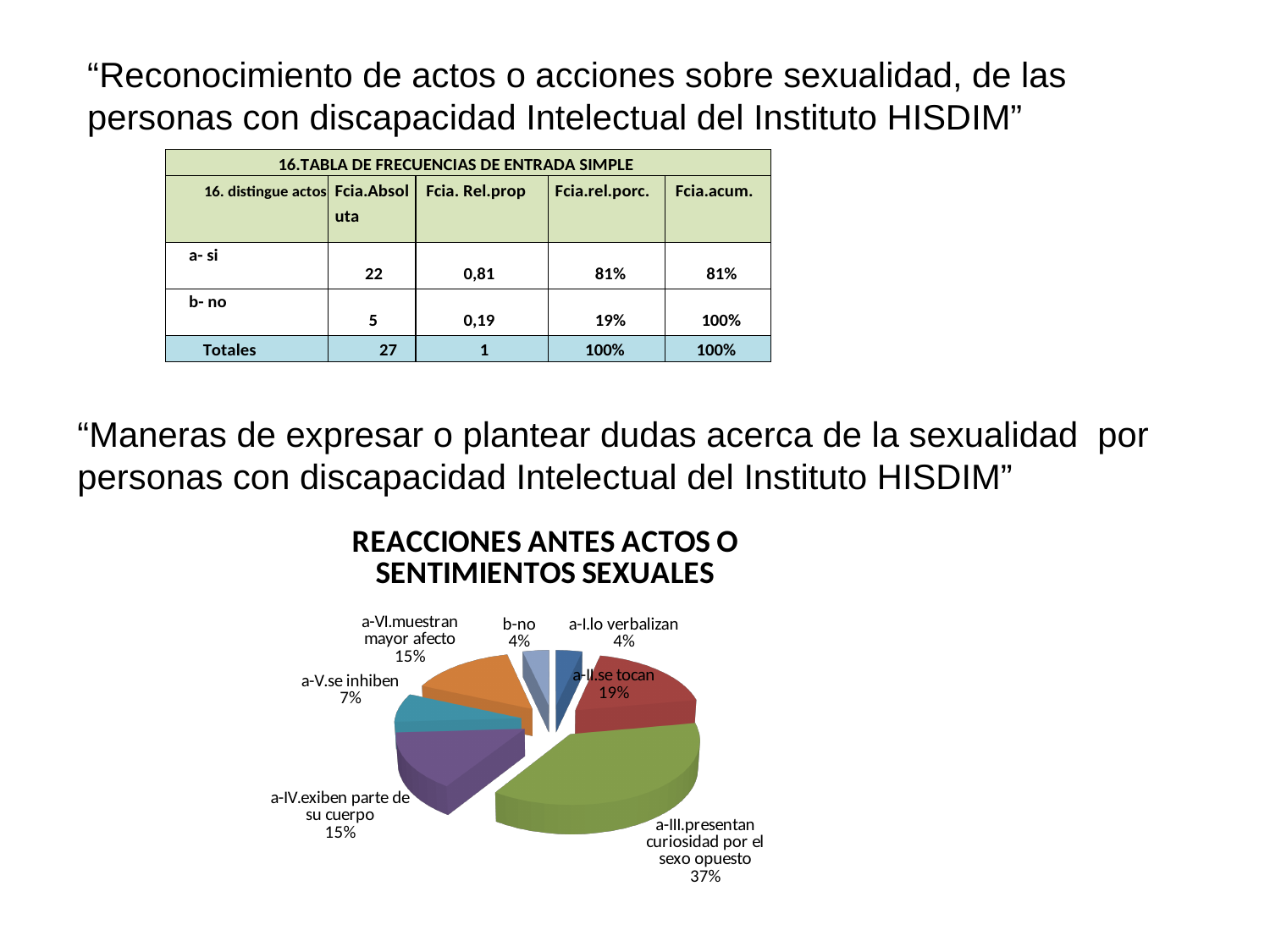
In the pie chart, what percentage is shown for "a-II.se tocan"? 19% In the pie chart, what percentage is shown for "b-no"? 4% What share of the pie does "a-IV.exiben parte de su cuerpo" represent? 15% How many slices does the pie chart have? 7 What is the title of the pie chart? REACCIONES ANTES ACTOS O SENTIMIENTOS SEXUALES In the pie chart, which is larger: "a-II.se tocan" or "a-IV.exiben parte de su cuerpo"? a-II.se tocan In the pie chart, what is the difference in percentage points between "a-III.presentan curiosidad por el sexo opuesto" and "a-II.se tocan"? 18 What kind of chart is shown under the title "REACCIONES ANTES ACTOS O SENTIMIENTOS SEXUALES"? pie chart In the pie chart, what percentage is shown for "a-V.se inhiben"? 7% Which slice of the pie chart is the largest? a-III.presentan curiosidad por el sexo opuesto In the pie chart, what percentage is shown for "a-VI.muestran mayor afecto"? 15% In the pie chart, what percentage is shown for "a-III.presentan curiosidad por el sexo opuesto"? 37%